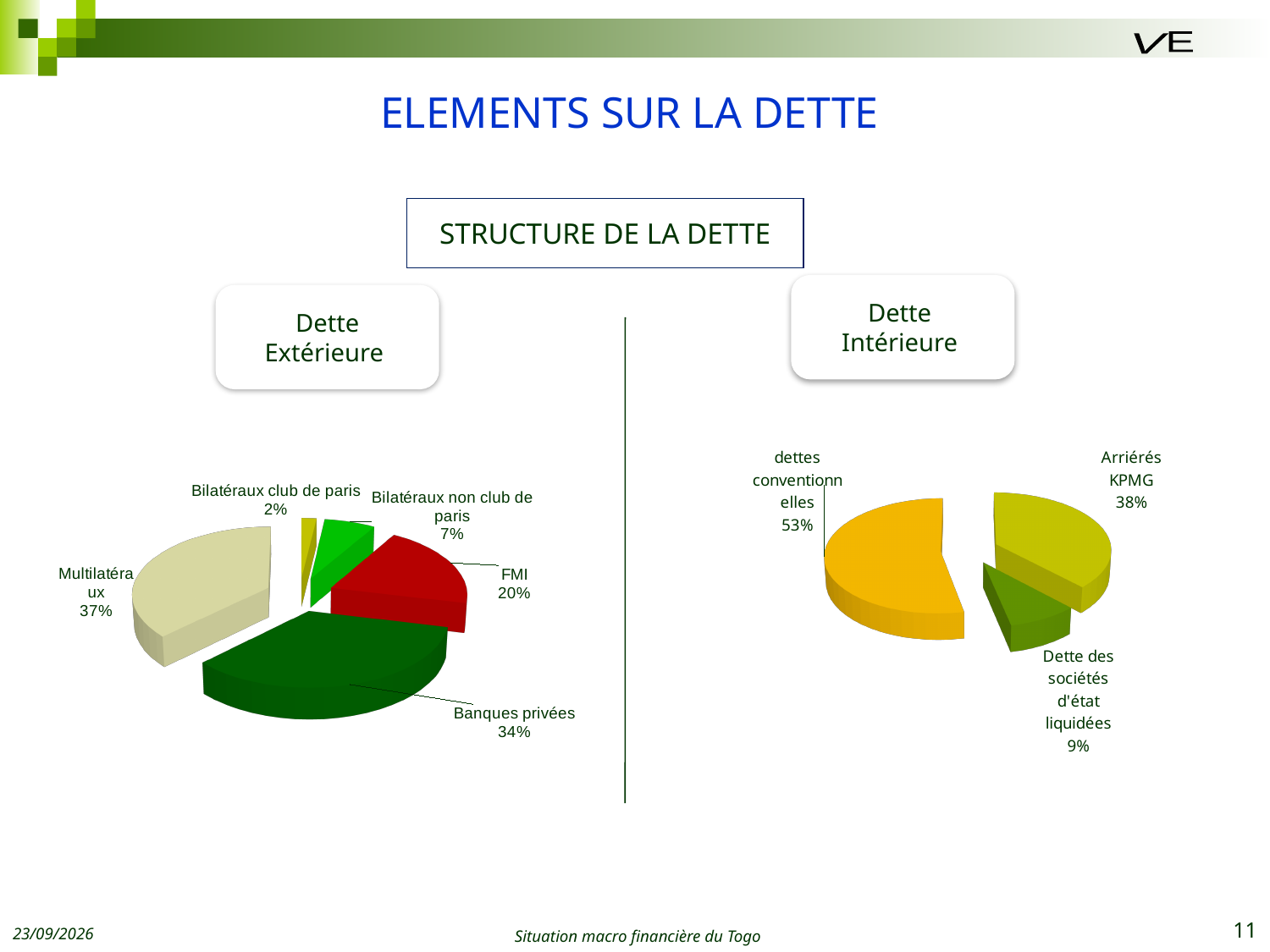
In the Dette Intérieure pie chart, what share is Dette des sociétés d'état liquidées? 9% In the Dette Extérieure pie chart, which category has the largest share? Multilatéraux In the Dette Extérieure pie chart, what is the difference between the shares of Banques privées and FMI? 14 percentage points In the Dette Intérieure pie chart, which category has the largest share? dettes conventionnelles In the Dette Extérieure pie chart, which is larger: Bilatéraux non club de paris or Bilatéraux club de paris? Bilatéraux non club de paris How many slices does the Dette Extérieure pie chart have? 5 In the Dette Extérieure pie chart, which category has the smallest share? Bilatéraux club de paris In the Dette Intérieure pie chart, what is the difference between the shares of Arriérés KPMG and Dette des sociétés d'état liquidées? 29 percentage points In the Dette Extérieure pie chart, what share is Multilatéraux? 37% In the Dette Intérieure pie chart, what share is dettes conventionnelles? 53% In the Dette Extérieure pie chart, what share is FMI? 20% What type of chart is used for Dette Intérieure? Pie chart